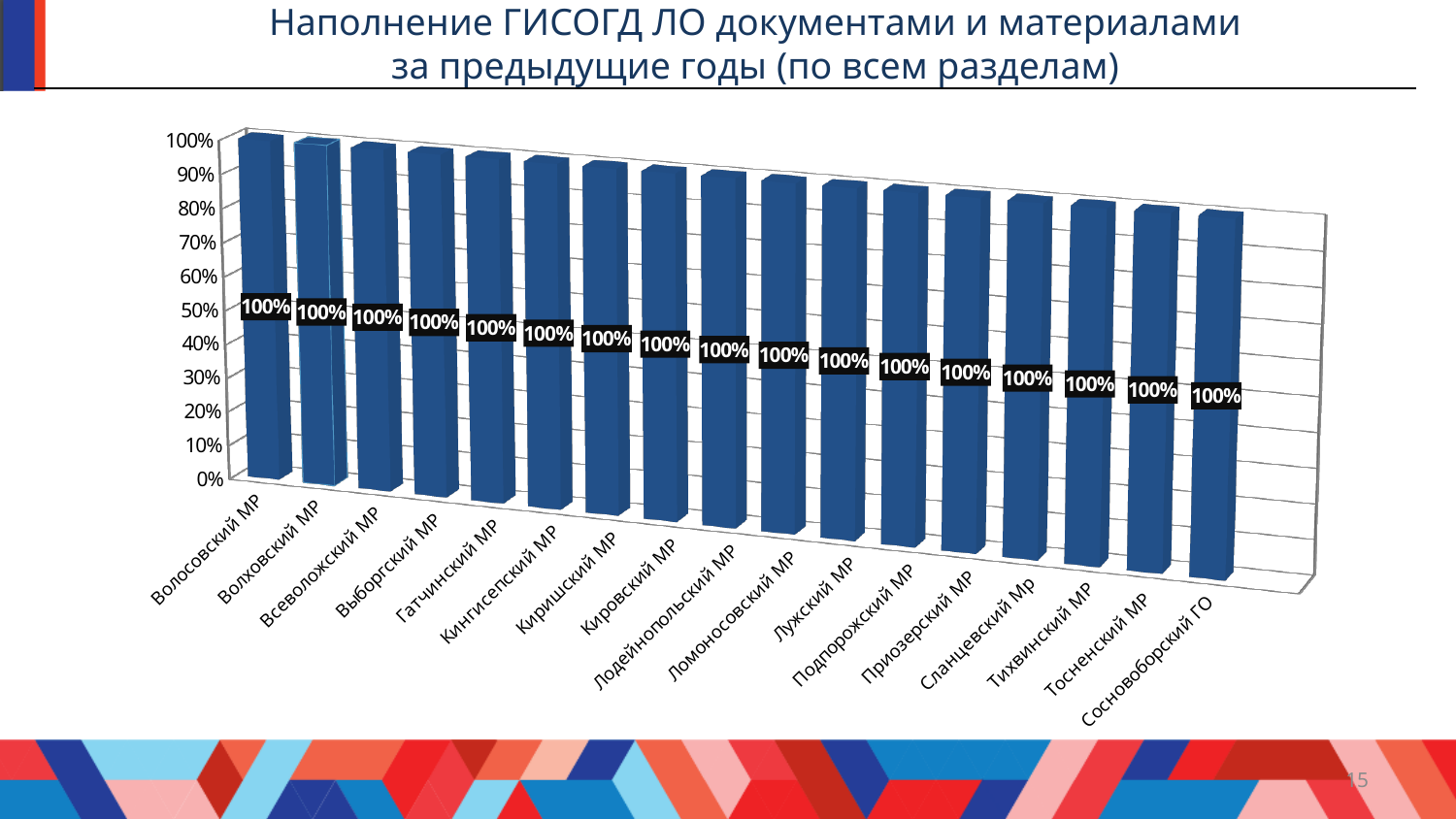
What type of chart is shown on the slide? bar chart How many categories (municipal districts) are shown on the x axis of the chart? 17 What is the value shown for Сосновоборский ГО? 100% What is the highest value shown on the vertical axis of the chart? 100% What is the value shown for Лужский МР? 100% What is the title of the slide containing the chart? Наполнение ГИСОГД ЛО документами и материалами за предыдущие годы (по всем разделам) What is the value shown for Гатчинский МР? 100% What is the value shown for Приозерский МР? 100% Is the value for Кировский МР greater or less than 90%? greater Do the values rise, fall, or stay the same across the categories along the x axis? stay the same What is the difference between the values for Выборгский МР and Тосненский МР? 0% What is the value shown for Волосовский МР? 100%